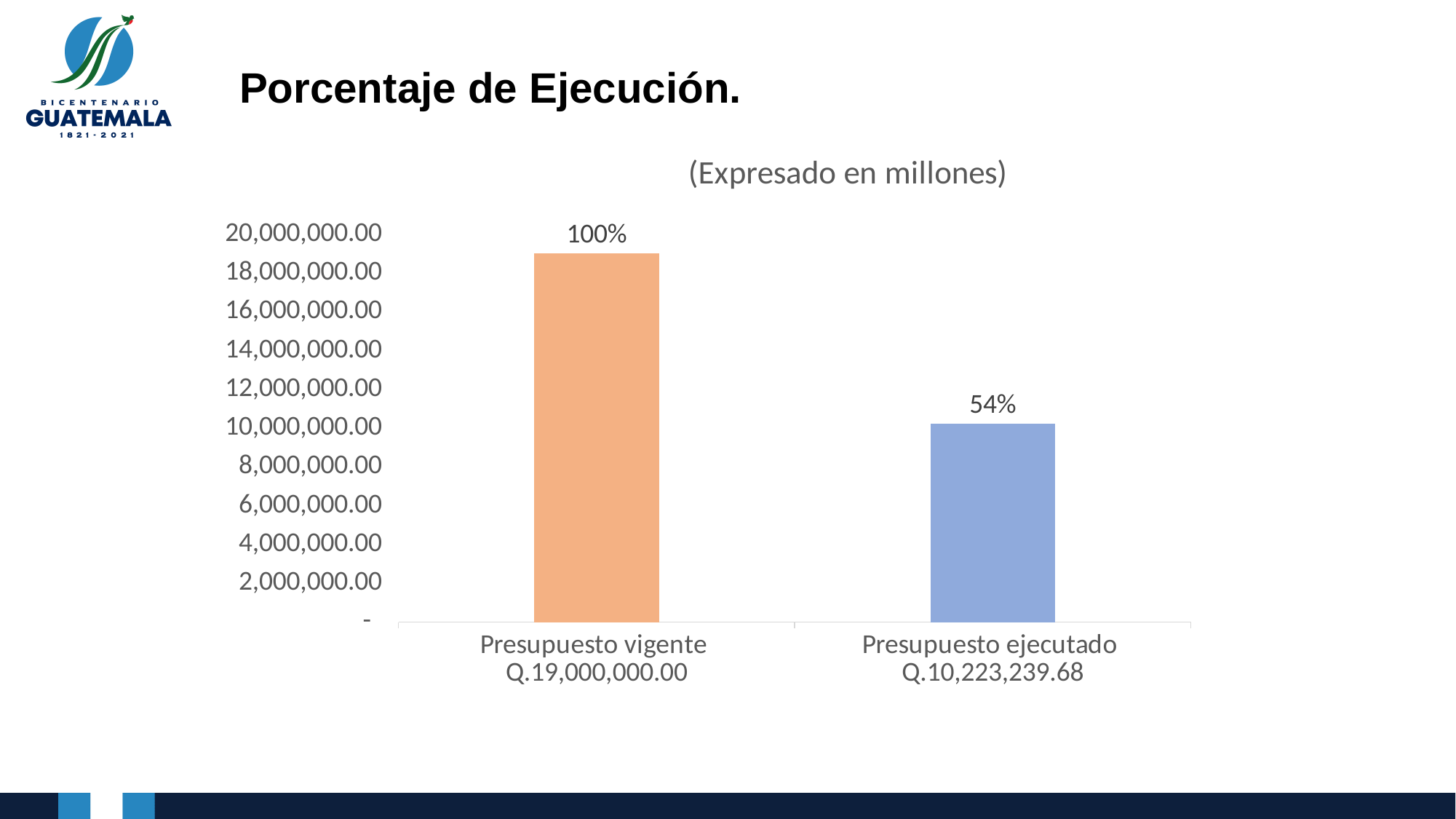
Is the bar for Presupuesto ejecutado greater or less than 12,000,000.00? less What amount is printed under the category label Presupuesto ejecutado? Q.10,223,239.68 What amount is printed under the category label Presupuesto vigente? Q.19,000,000.00 What kind of chart is shown on the slide? bar chart What is the title printed above the chart? (Expresado en millones) How many bars are plotted in the chart? 2 Which category has the shorter bar? Presupuesto ejecutado Is the bar for Presupuesto vigente greater or less than 18,000,000.00? greater What data label is shown above the bar for Presupuesto vigente? 100% What data label is shown above the bar for Presupuesto ejecutado? 54% Which category has the taller bar? Presupuesto vigente What is the difference in percentage points between the data labels of Presupuesto vigente and Presupuesto ejecutado? 46%